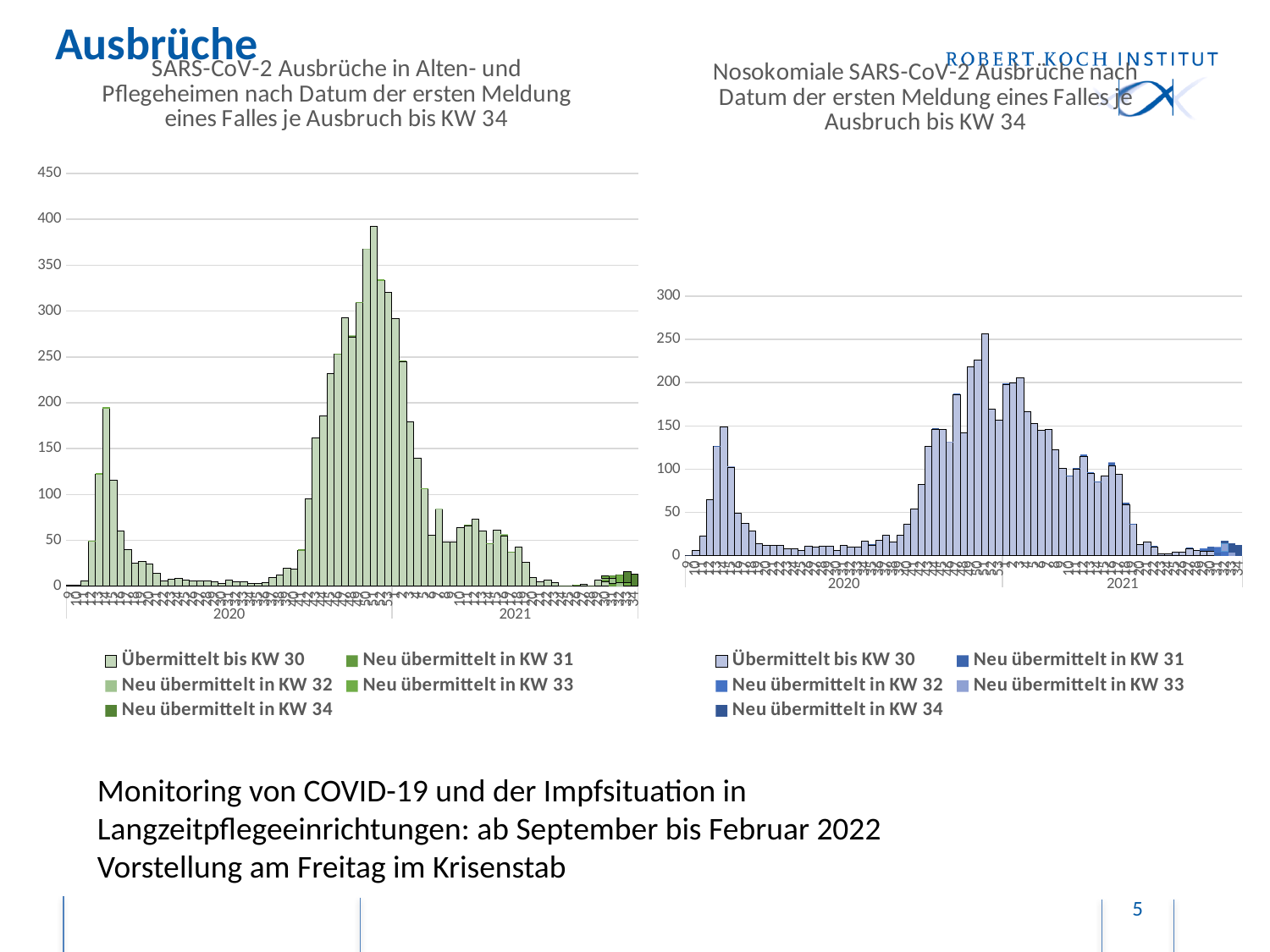
What kind of chart is the right chart, 'Nosokomiale SARS-CoV-2 Ausbrüche'? bar chart In the left chart, are the bars at the far right end of 2021 greater or less than 50? less How many series does the legend of the right chart list? 5 In the left chart, is the tallest bar of the early-2020 peak greater or less than 150? greater In the right chart, is the tallest bar greater or less than 200? greater How many series does the legend of the left chart list? 5 Which chart has the higher peak value, the left chart or the right chart? the left chart What kind of chart is the left chart, 'SARS-CoV-2 Ausbrüche in Alten- und Pflegeheimen'? bar chart Which years are labelled on the x axis of the right chart? 2020 and 2021 What is the first legend entry of the left chart? Übermittelt bis KW 30